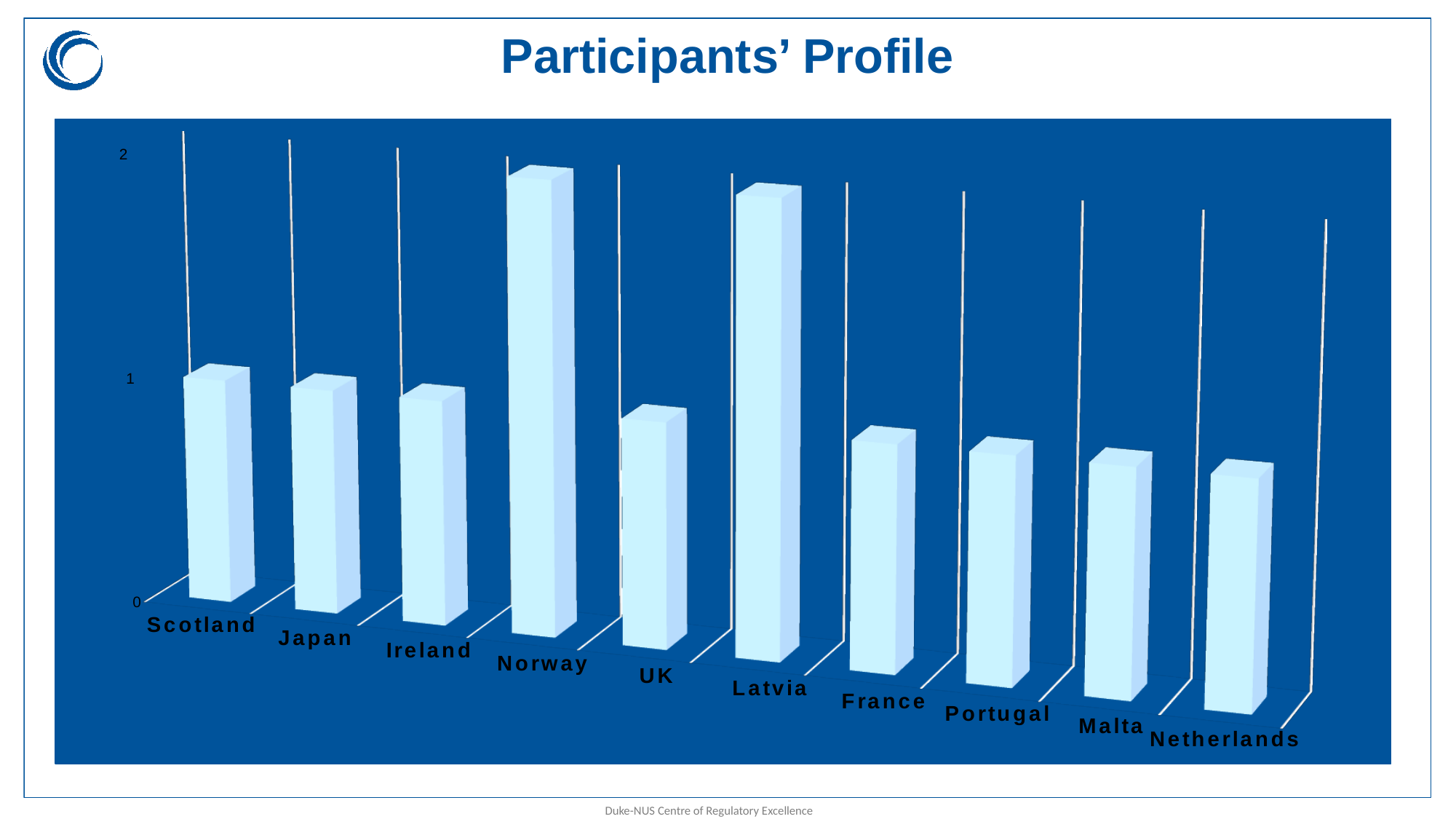
Which country is listed first on the x axis of the chart? Scotland What is the title of the slide containing the chart? Participants' Profile Is the value for Norway greater or less than 1? greater Is the value for Netherlands greater or less than 2? less Which has the larger value, Latvia or UK? Latvia Which has the larger value, Norway or Scotland? Norway Which has the larger value, Malta or Latvia? Latvia What kind of chart is shown on the slide? bar chart Is the value for Latvia greater or less than 1? greater How many countries are shown on the x axis of the chart? 10